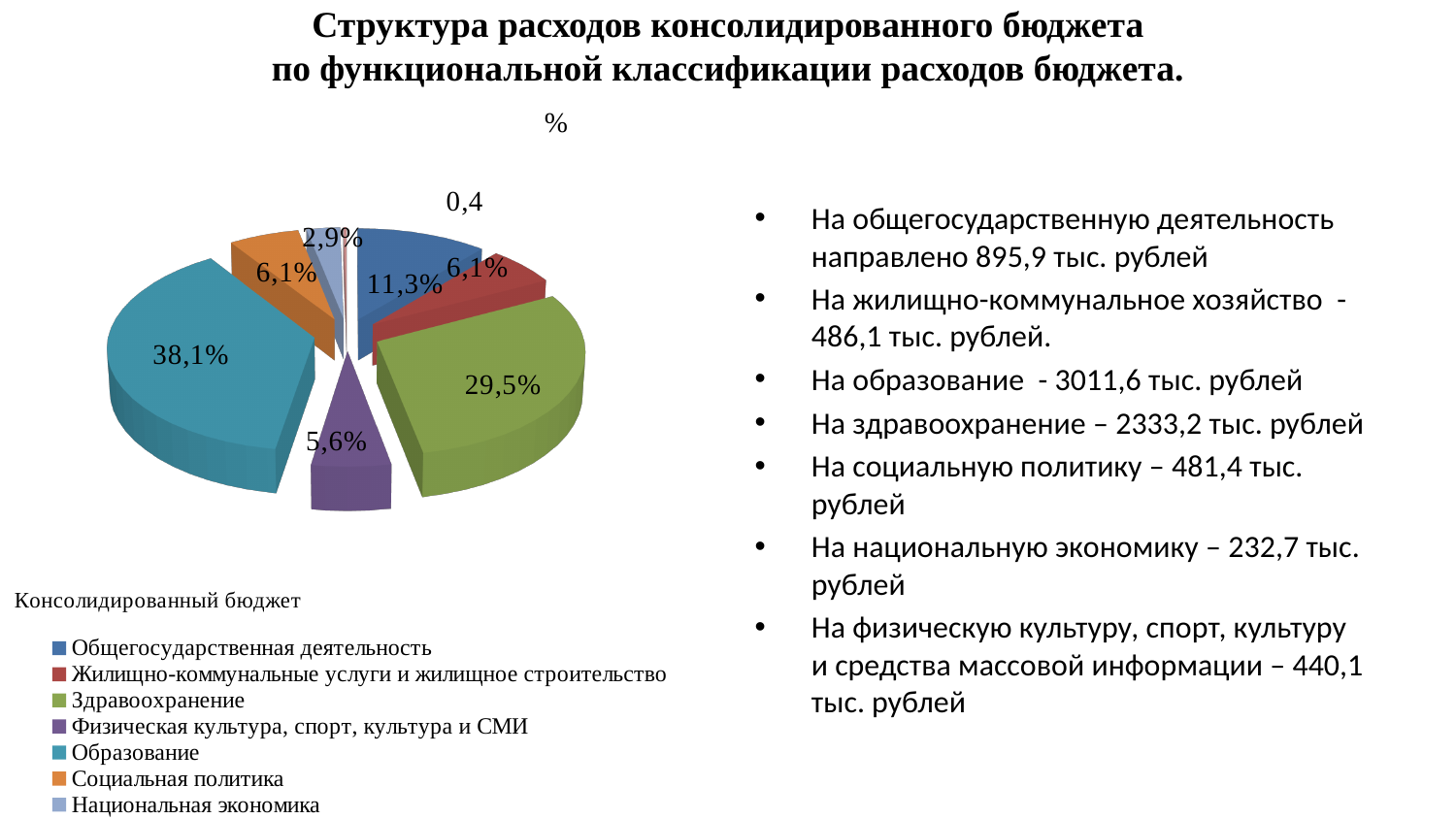
What is the difference in percentage points between Образование and Здравоохранение? 8,6 What percentage is shown for Здравоохранение? 29,5% Which is larger, the share for Общегосударственная деятельность or for Физическая культура, спорт, культура и СМИ? Общегосударственная деятельность What percentage does Национальная экономика have in the pie chart? 2,9% What value is labelled for Общегосударственная деятельность? 11,3% Which category has the largest slice of the pie? Образование What share of the pie does Образование account for? 38,1% What share is shown for Физическая культура, спорт, культура и СМИ? 5,6% How many entries does the chart legend list? 7 What colour is the slice for Здравоохранение? Green What value is shown for Социальная политика? 6,1% What type of chart is shown on the slide? Pie chart